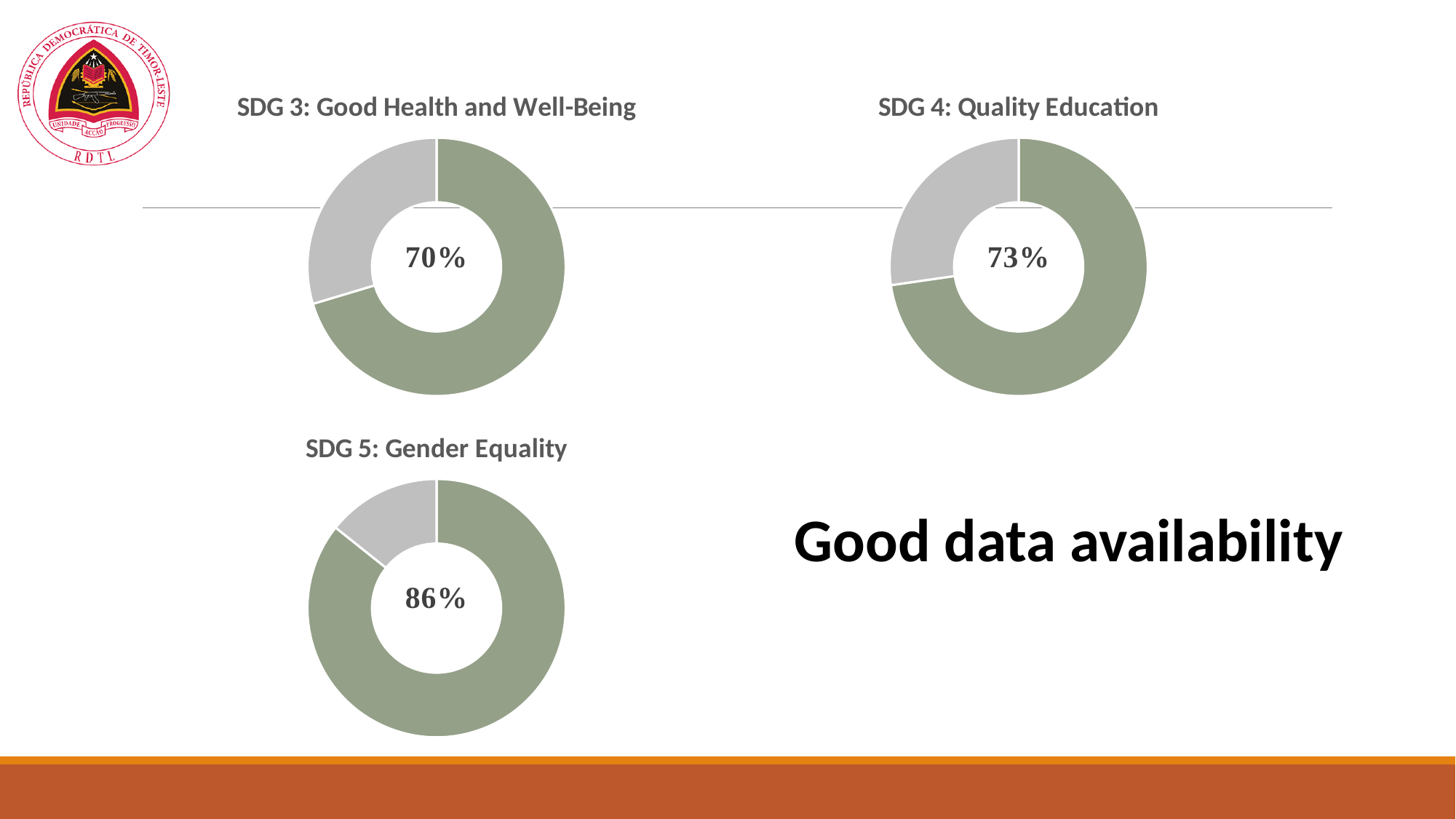
Which chart shows a larger percentage, 'SDG 4: Quality Education' or 'SDG 5: Gender Equality'? SDG 5: Gender Equality In the chart titled 'SDG 4: Quality Education', what percentage is shown in the centre of the doughnut? 73% What is the title of the chart in the bottom-left of the slide? SDG 5: Gender Equality In the chart titled 'SDG 5: Gender Equality', what percentage is shown in the centre of the doughnut? 86% How many doughnut charts are shown on the slide? 3 Across the three charts on the slide, which SDG chart shows the highest percentage? SDG 5: Gender Equality Across the three charts on the slide, which SDG chart shows the lowest percentage? SDG 3: Good Health and Well-Being What kind of chart is used for 'SDG 3: Good Health and Well-Being'? Doughnut chart What is the difference between the percentage in the 'SDG 5: Gender Equality' chart and the percentage in the 'SDG 3: Good Health and Well-Being' chart? 16% In the 'SDG 5: Gender Equality' chart, what share of the doughnut does the green slice represent? 86% In the chart titled 'SDG 3: Good Health and Well-Being', what percentage is shown in the centre of the doughnut? 70% What is the difference between the percentage in the 'SDG 4: Quality Education' chart and the percentage in the 'SDG 3: Good Health and Well-Being' chart? 3%